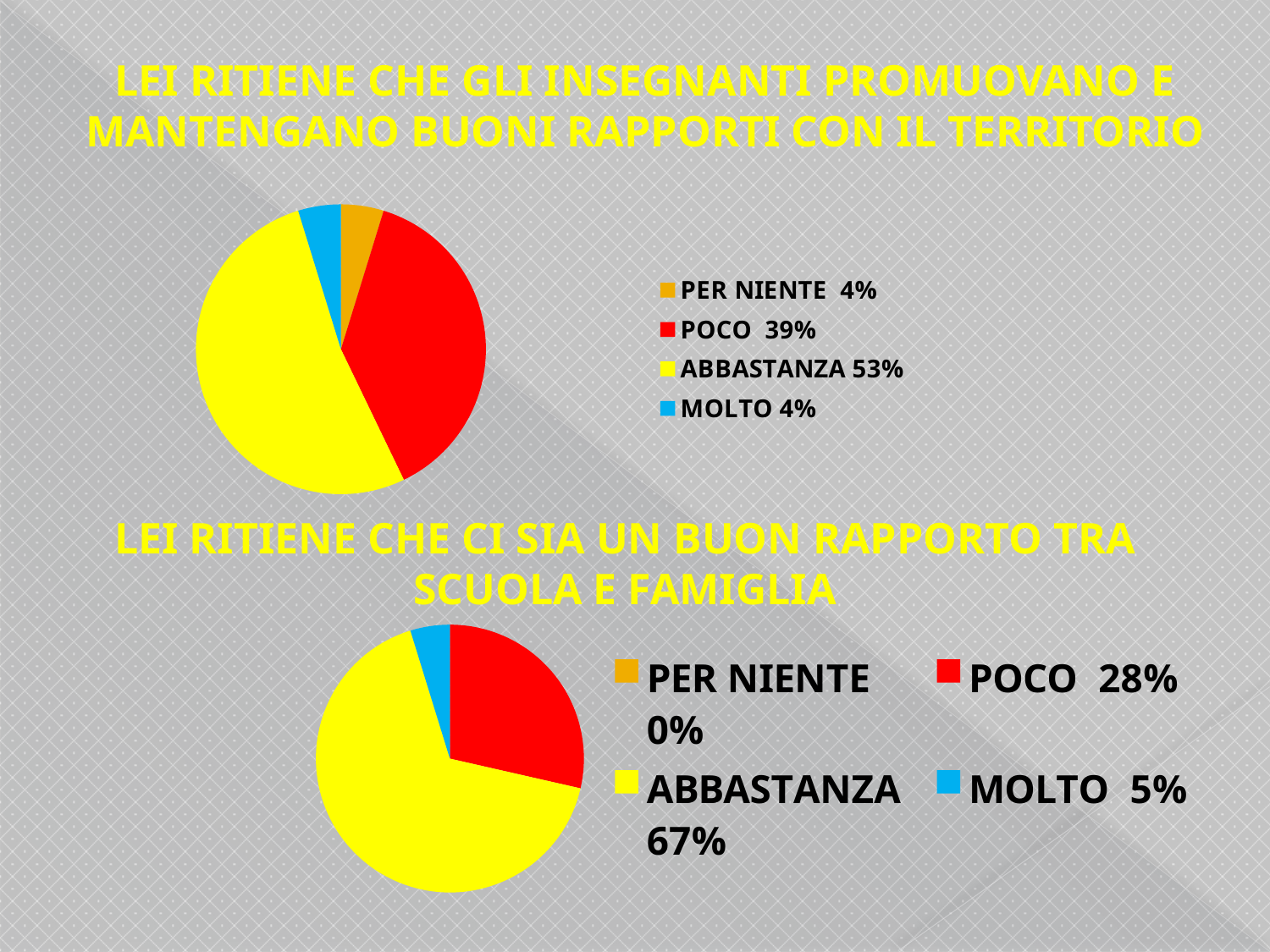
In the bottom pie chart (about school and family), which category has the smallest share? PER NIENTE In the bottom pie chart (about school and family), what percentage is shown for ABBASTANZA? 67% What type of chart is used on this slide? Pie chart In the bottom pie chart (about school and family), what is the difference between the ABBASTANZA and POCO percentages? 39% In the top pie chart (about teachers and the territory), what is the difference between the ABBASTANZA and POCO percentages? 14% In the top pie chart (about teachers and the territory), what percentage is shown for POCO? 39% In the top pie chart (about teachers and the territory), what colour represents MOLTO? Blue In the top pie chart (about teachers and the territory), how many categories does the legend list? 4 In the top pie chart (about teachers and the territory), what percentage is shown for ABBASTANZA? 53% In the top pie chart (about teachers and the territory), which category has the largest share? ABBASTANZA In the bottom pie chart (about school and family), what percentage is shown for MOLTO? 5% In the bottom pie chart (about school and family), which is larger, POCO or MOLTO? POCO